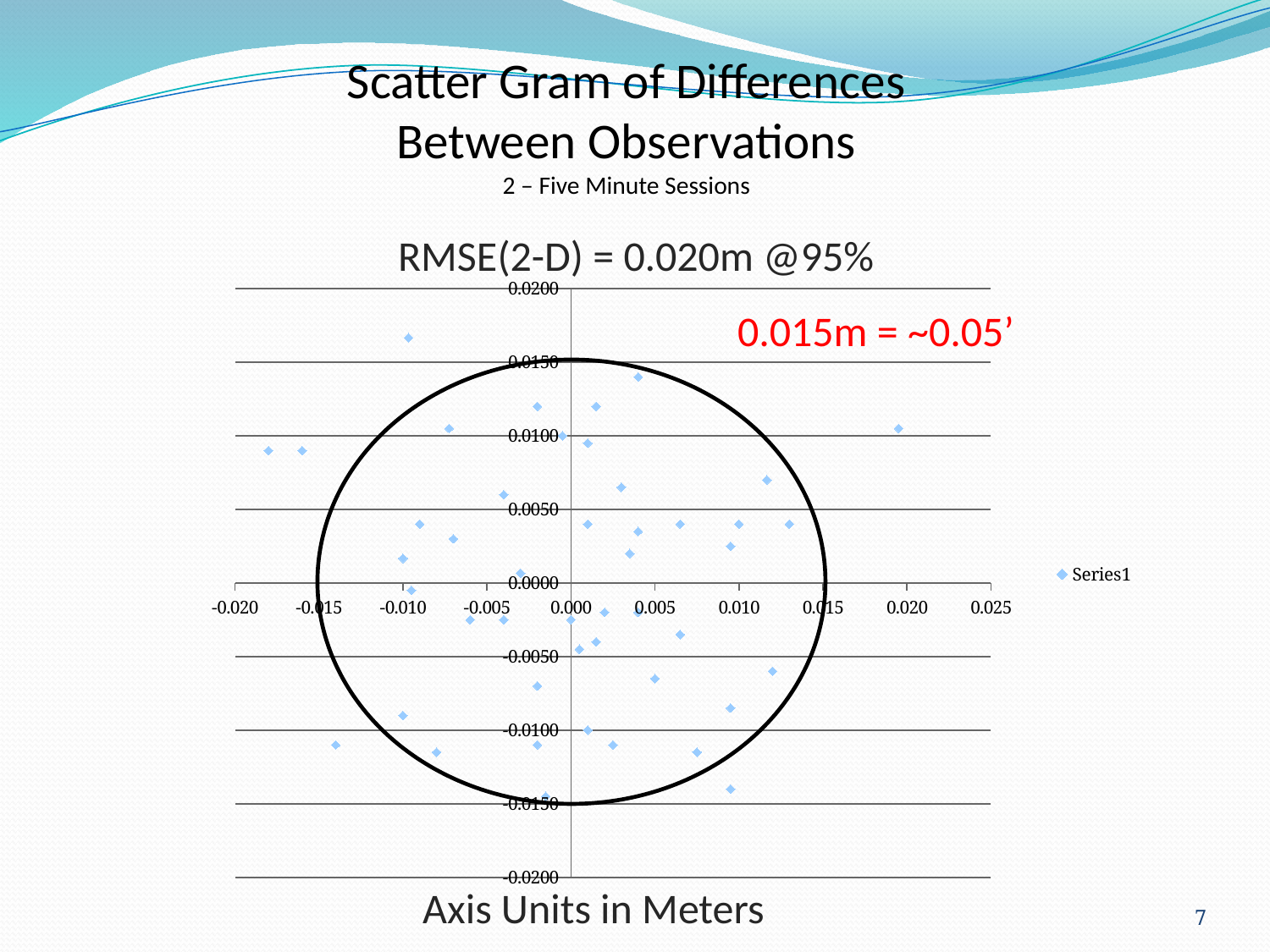
What kind of chart is shown on the slide? scatter chart Is the lowest y value plotted in the chart greater or less than -0.0100? less What is the name of the series shown in the chart legend? Series1 Is the x value of the rightmost point in the chart greater or less than 0.020? less Is the highest y value plotted in the chart greater or less than 0.0200? less How many series does the chart legend list? 1 What is the title of the chart? RMSE(2-D) = 0.020m @95%